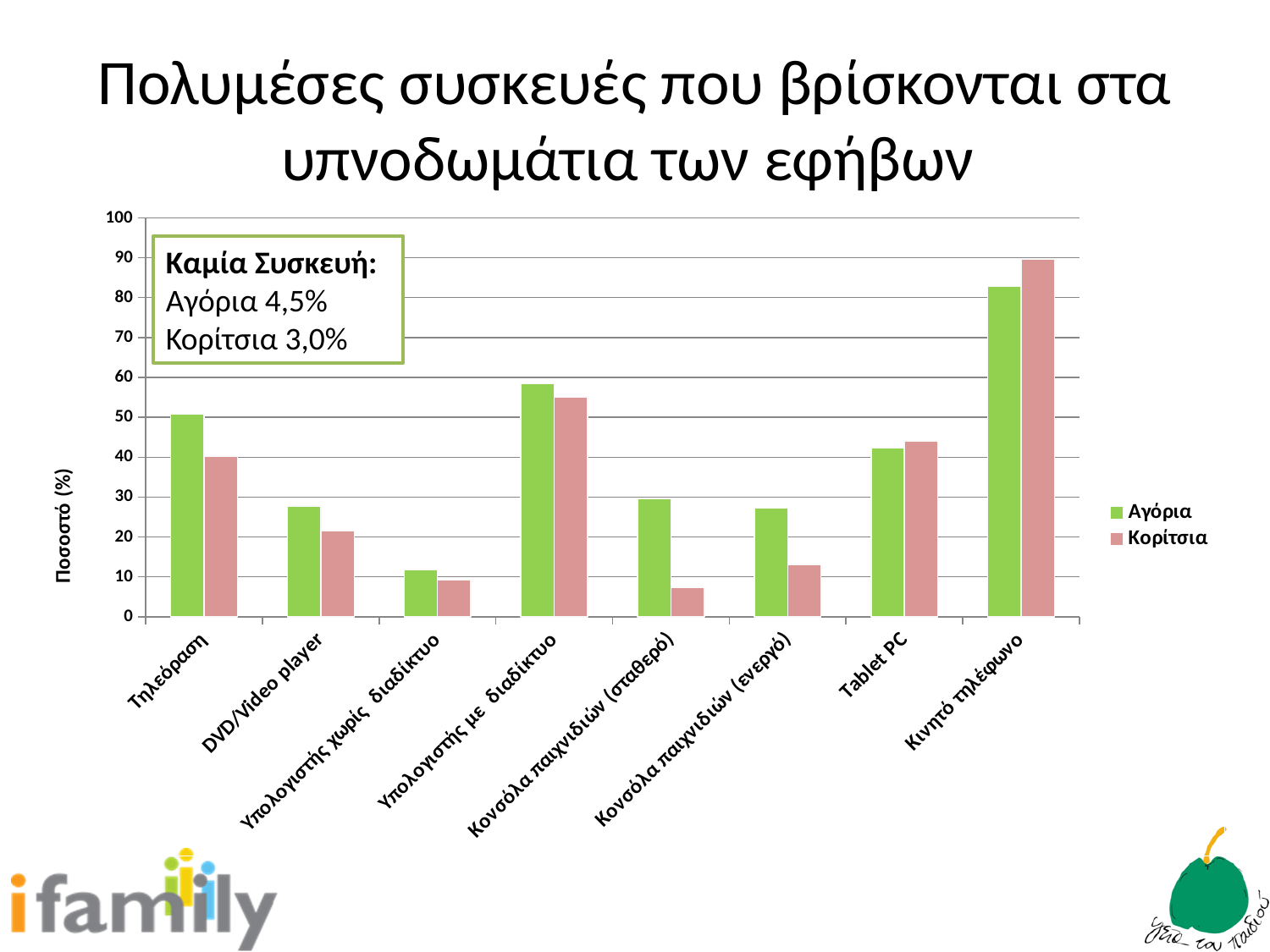
According to the text box on the chart, what is the Αγόρια percentage for Καμία Συσκευή? 4,5% For which category is the Αγόρια value highest? Κινητό τηλέφωνο Is the Αγόρια value for Υπολογιστής με διαδίκτυο greater or less than 50? greater Is the Κορίτσια value for Κονσόλα παιχνιδιών (σταθερό) greater or less than 10? less For Κινητό τηλέφωνο, which series has the larger value, Αγόρια or Κορίτσια? Κορίτσια For which category is the Αγόρια value lowest? Υπολογιστής χωρίς διαδίκτυο For Τηλεόραση, which series has the larger value, Αγόρια or Κορίτσια? Αγόρια How many device categories are shown on the x axis? 8 How many series does the legend list? 2 Is the Κορίτσια value for Κινητό τηλέφωνο greater or less than 80? greater What is the label of the vertical axis? Ποσοστό (%) What kind of chart is shown on the slide? bar chart